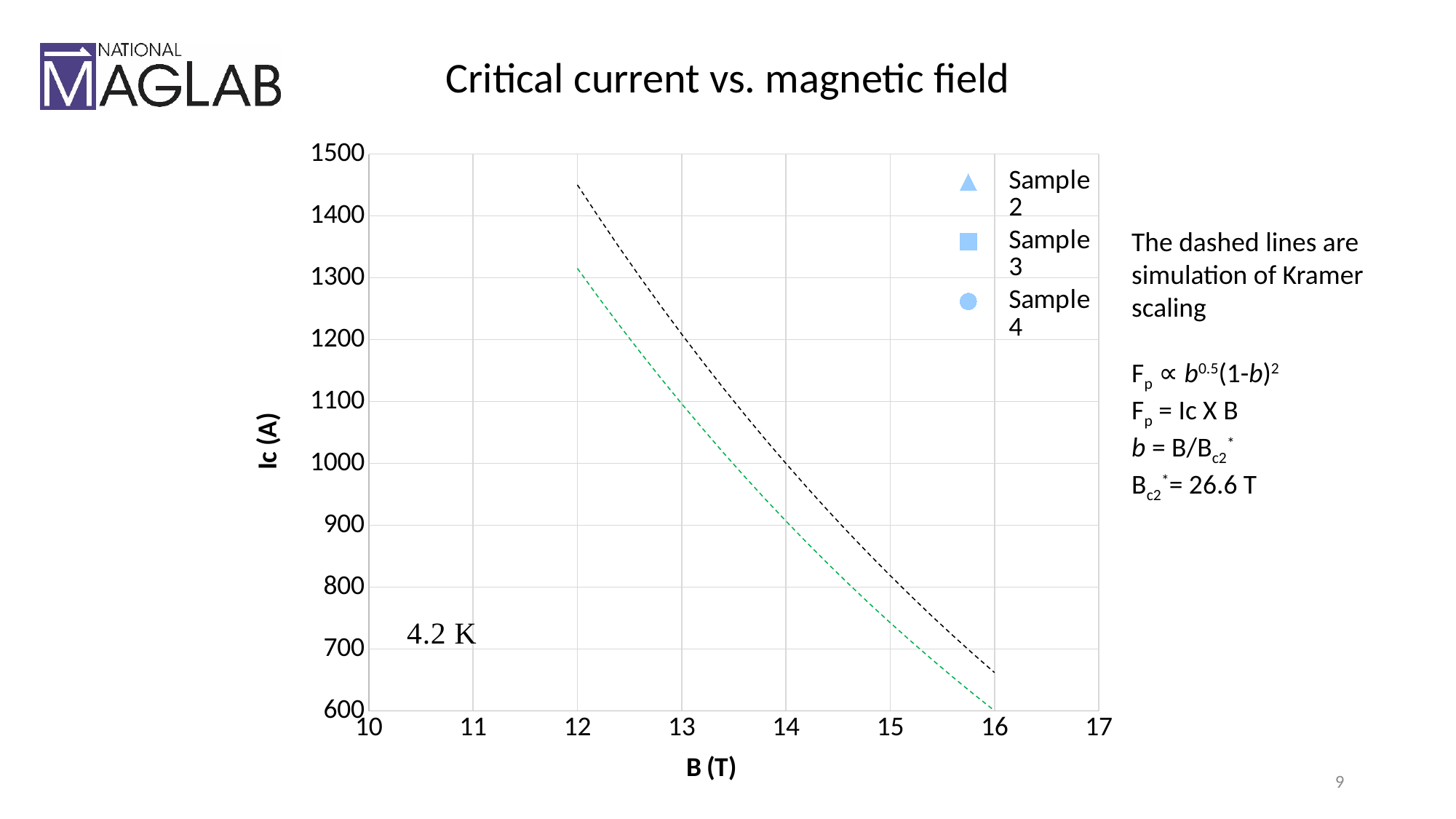
What kind of chart is shown on the slide? line chart Is the value of the black dashed line at 12 T greater or less than 1400? greater Which dashed line has the higher Ic at 12 T, the black one or the green one? black How many series does the legend list? 3 Is the value of the green dashed line at 16 T greater or less than 700? less What is the maximum value shown on the Ic (A) axis? 1500 What is the label of the x axis? B (T) Is the value of the green dashed line at 12 T greater or less than 1200? greater Do the dashed lines rise or fall as B increases along the x axis? fall What is the title of the chart? Critical current vs. magnetic field What temperature is annotated on the chart? 4.2 K